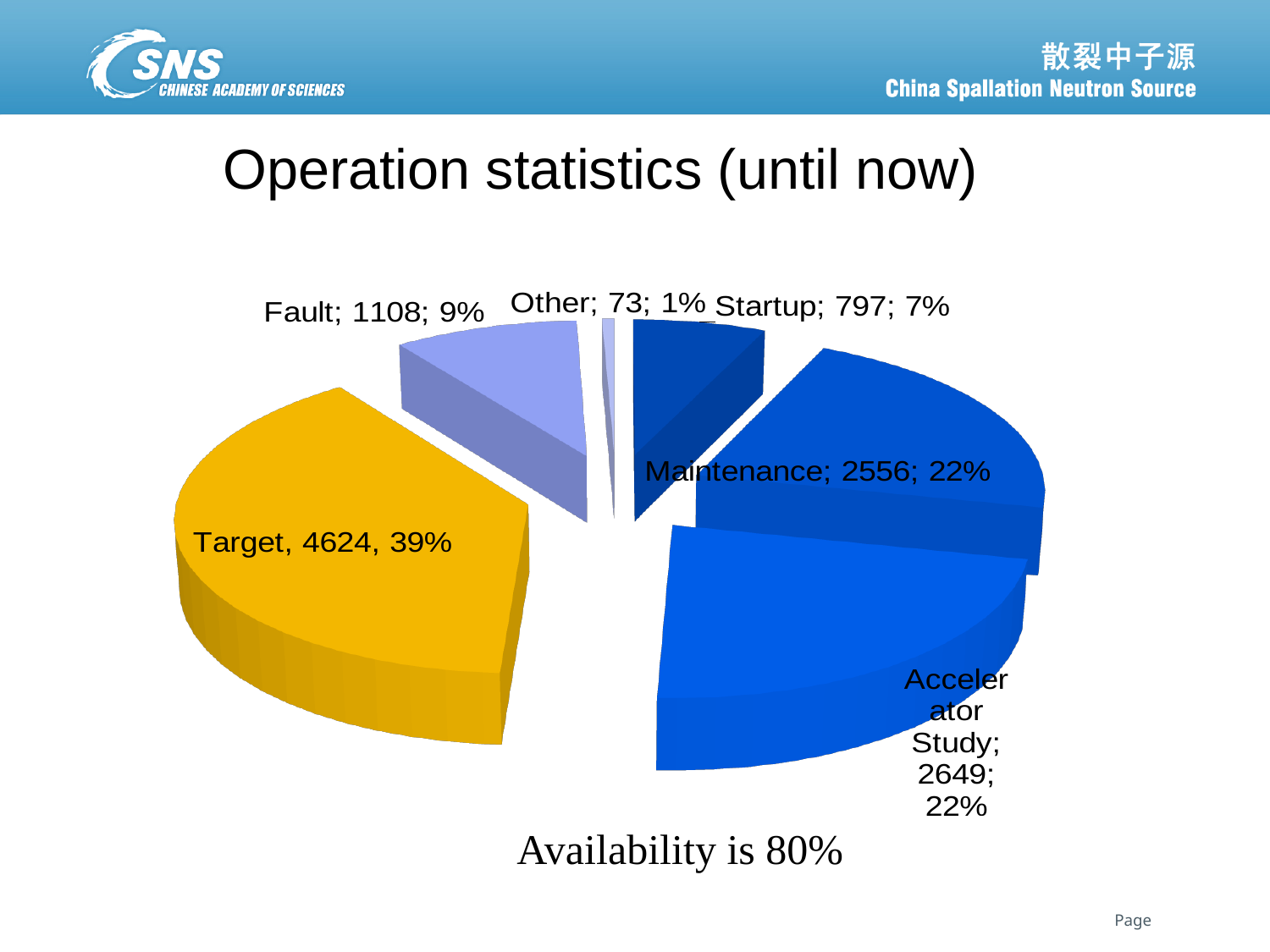
Which category has the smallest slice of the pie? Other What is the value for Maintenance in the pie chart? 2556 What share of the pie does Startup represent? 7% What is the difference between the values for Target and Maintenance? 2068 What share of the pie does Accelerator Study represent? 22% What is the value for Fault in the pie chart? 1108 Which category has the largest slice of the pie? Target Which is larger, the value for Fault or the value for Startup? Fault How many slices does the pie chart have? 6 What kind of chart is shown on the slide? pie chart What is the value for Target in the pie chart? 4624 What availability figure is stated below the pie chart? 80%